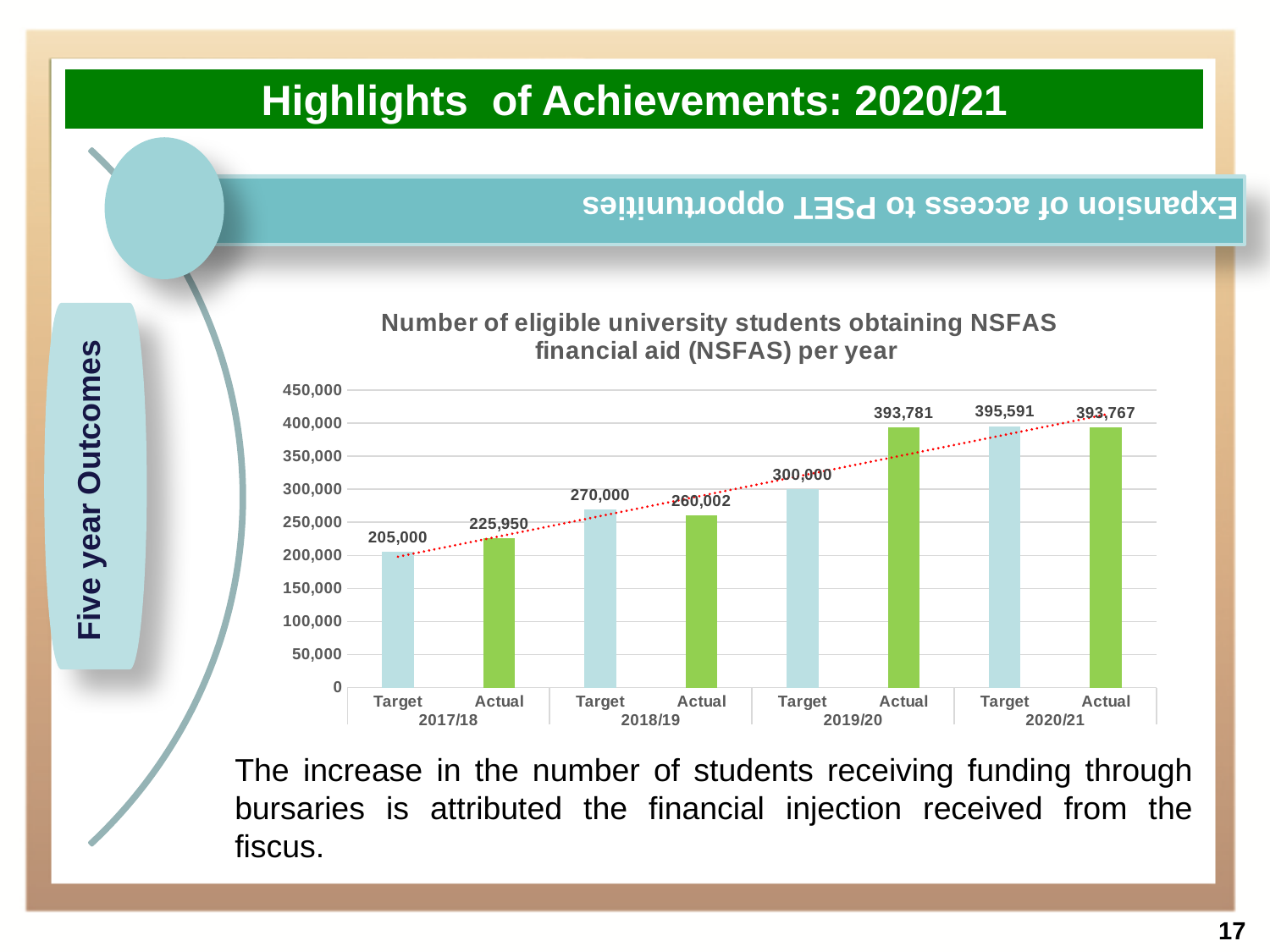
Which bar has the lowest value in the chart? Target 2017/18 What type of chart is shown on the slide? Bar chart How many bars are plotted in the chart? 8 What is the Actual value for 2018/19? 260,002 What is the difference between the Actual and Target values for 2017/18? 20,950 Which bar has the highest value in the chart? Target 2020/21 What is the Actual value for 2019/20? 393,781 What is the difference between the Actual and Target values for 2019/20? 93,781 Which is larger for 2018/19, the Target or the Actual value? Target What is the Target value for 2020/21? 395,591 What is the title of the chart? Number of eligible university students obtaining NSFAS financial aid (NSFAS) per year What is the Target value for 2017/18? 205,000